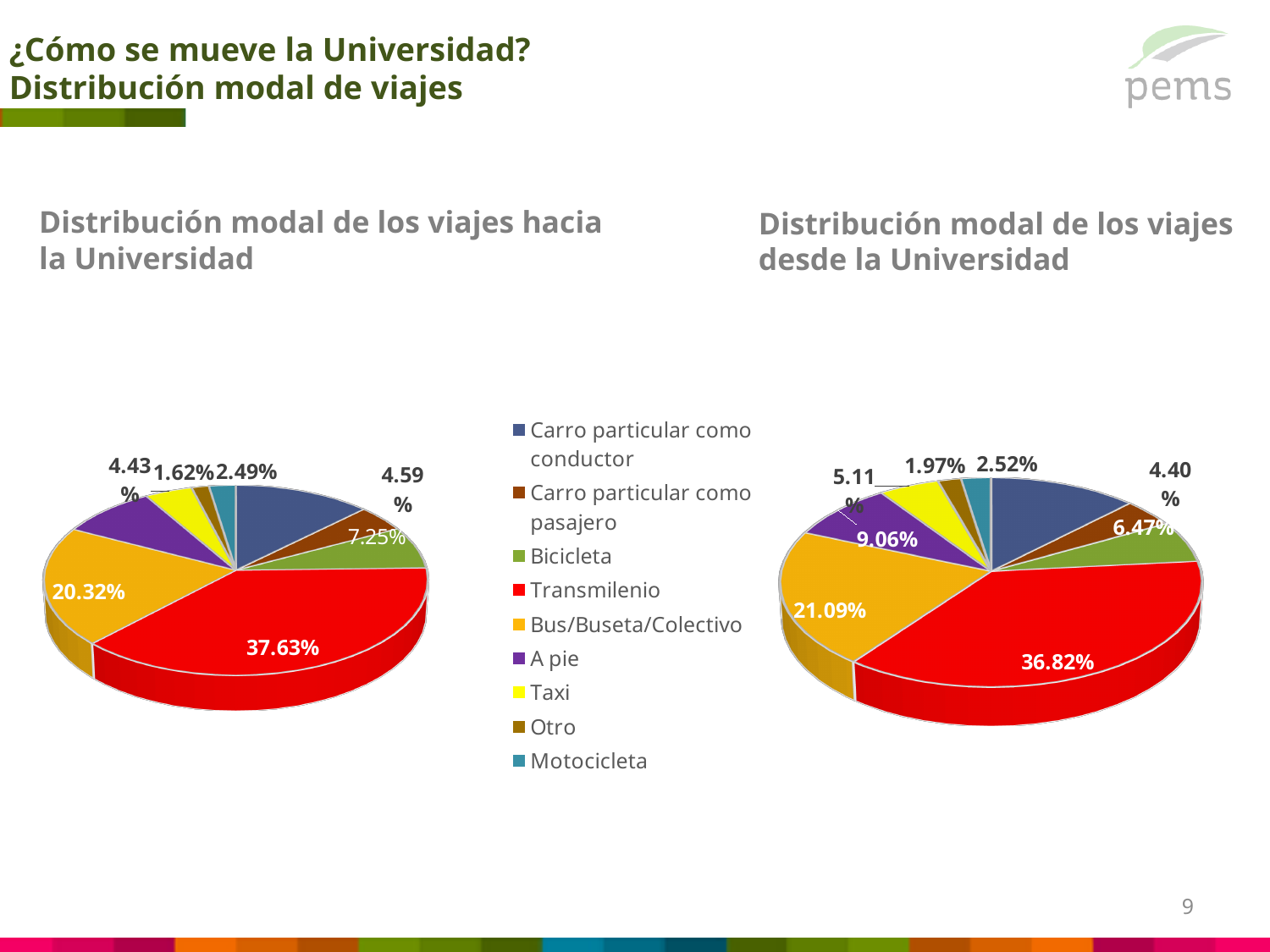
Is the Transmilenio share larger in the chart 'hacia la Universidad' or in the chart 'desde la Universidad'? hacia la Universidad In the pie chart 'Distribución modal de los viajes desde la Universidad', what share of trips is Taxi? 5.11% How many modes does the shared legend list for the two pie charts? 9 In the pie chart 'Distribución modal de los viajes desde la Universidad', what share of trips is A pie? 9.06% In the pie chart 'Distribución modal de los viajes desde la Universidad', which mode has the largest share? Transmilenio In the pie chart 'Distribución modal de los viajes hacia la Universidad', what share of trips is Bicicleta? 7.25% What type of chart is 'Distribución modal de los viajes desde la Universidad'? Pie chart In the pie chart 'Distribución modal de los viajes desde la Universidad', what share of trips is Transmilenio? 36.82% In the pie chart 'Distribución modal de los viajes hacia la Universidad', what share of trips is Bus/Buseta/Colectivo? 20.32% In the pie chart 'Distribución modal de los viajes hacia la Universidad', what is the difference between the Transmilenio share and the Bus/Buseta/Colectivo share? 17.31% What colour represents Transmilenio in the pie charts? Red In the pie chart 'Distribución modal de los viajes hacia la Universidad', what share of trips is Transmilenio? 37.63%